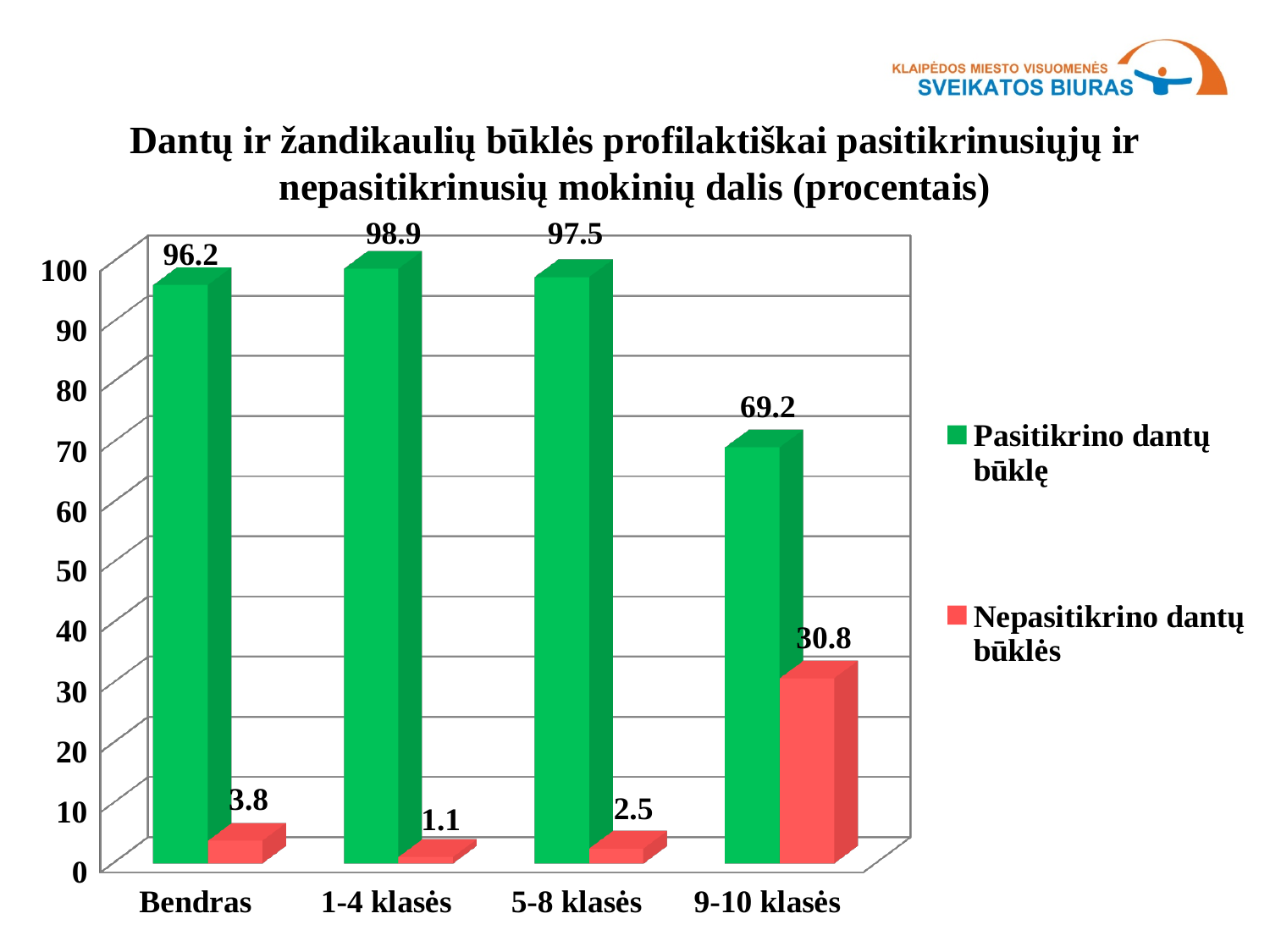
What is the value for 'Pasitikrino dantų būklę' in the '1-4 klasės' category? 98.9 What is the value for 'Nepasitikrino dantų būklės' in the 'Bendras' category? 3.8 What kind of chart is shown on the slide? bar chart What is the difference between the 'Pasitikrino dantų būklę' and 'Nepasitikrino dantų būklės' values for '9-10 klasės'? 38.4 Which is larger: the 'Pasitikrino dantų būklę' value for '5-8 klasės' or for 'Bendras'? 5-8 klasės What colour are the bars for the 'Nepasitikrino dantų būklės' series? red Which category has the lowest value for 'Nepasitikrino dantų būklės'? 1-4 klasės Which category has the highest value for 'Pasitikrino dantų būklę'? 1-4 klasės What is the value for 'Nepasitikrino dantų būklės' in the '9-10 klasės' category? 30.8 How many series does the legend list? 2 Is the 'Pasitikrino dantų būklę' value for '9-10 klasės' greater or less than 80? less How many categories are shown on the x axis? 4